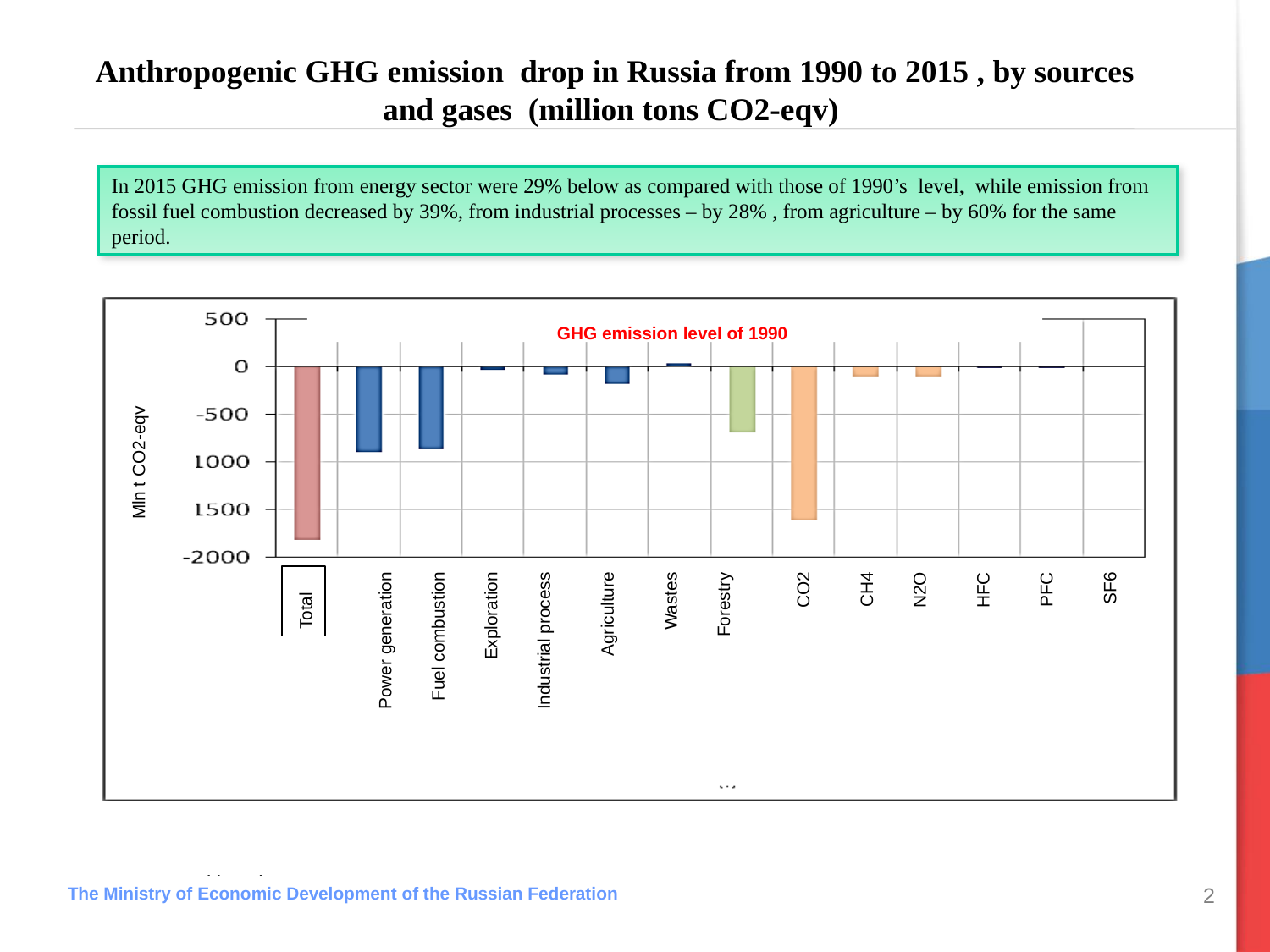
Is the value for Agriculture greater or less than -500? greater Which has the lower value, Total or CO2? Total Which has the lower value, Forestry or Agriculture? Forestry Is the value for Forestry greater or less than -1000? greater What is the label on the vertical axis of the chart? Mln t CO2-eqv What kind of chart is shown on the slide? bar chart Is the value for CO2 greater or less than -1500? less How many categories are plotted along the x axis of the chart? 14 Which category is the only one with a positive value in the chart? Wastes Which category has the lowest (most negative) value in the chart? Total